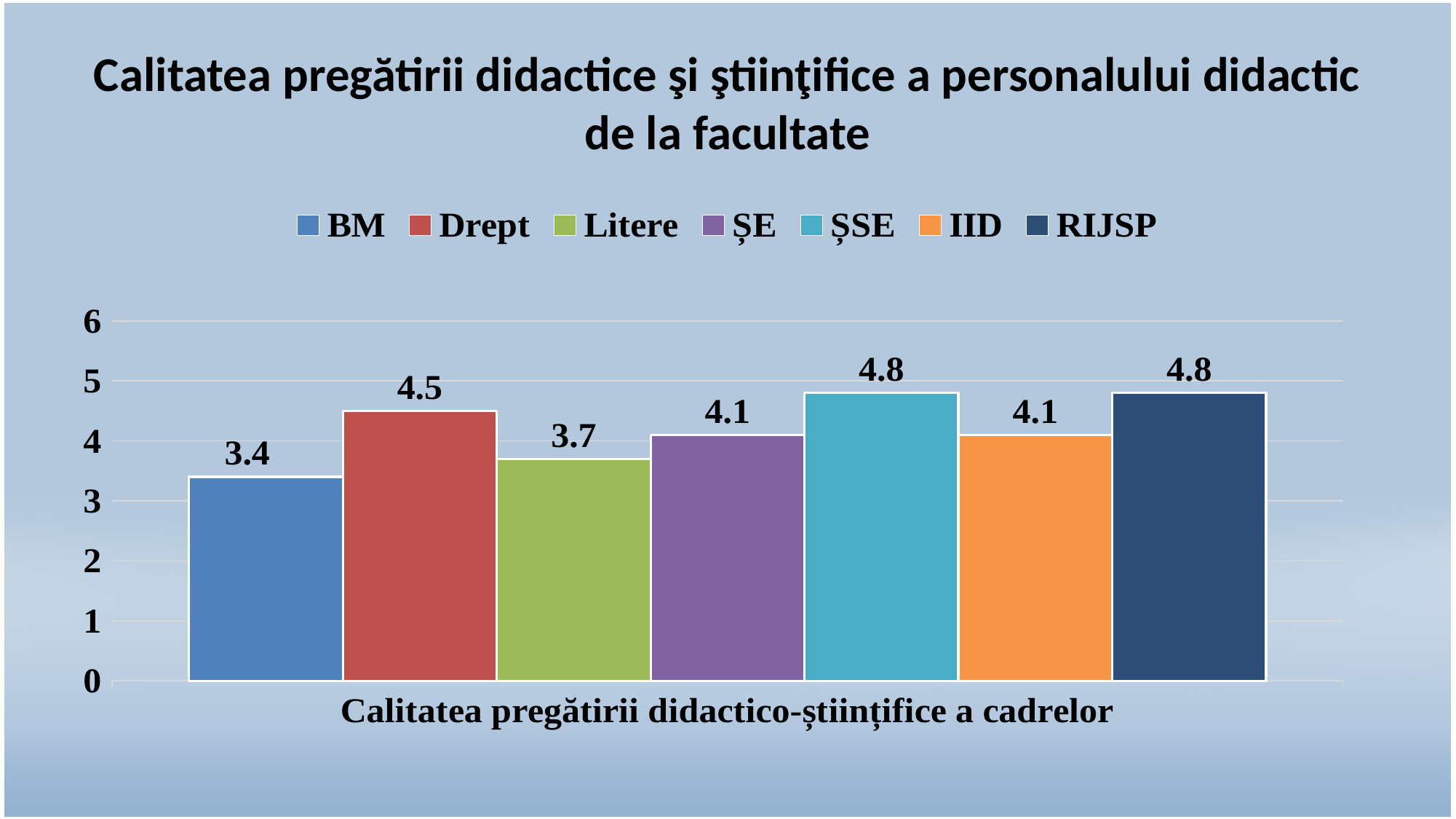
What is the difference between the values for ȘSE and Litere? 1.1 What colour is the bar for IID? Orange What is the difference between the values for Drept and BM? 1.1 What kind of chart is shown on the slide? Bar chart What is the value for BM? 3.4 How many series does the legend list? 7 What is the value for Drept? 4.5 What is the value for IID? 4.1 What is the value for Litere? 3.7 What is the highest value shown on the chart? 4.8 Which is larger, the value for Drept or the value for ȘE? Drept Which series has the lowest value? BM